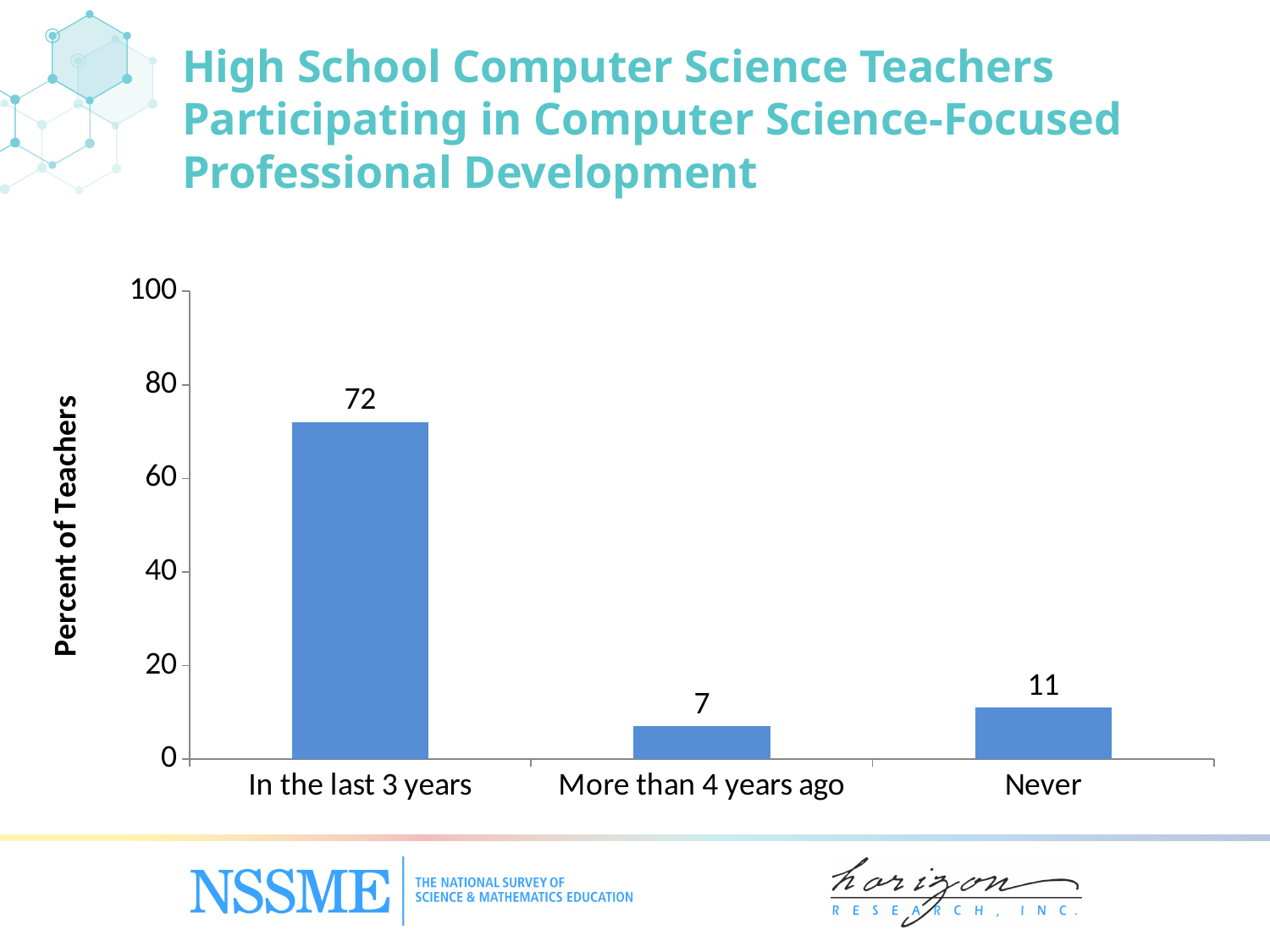
How many categories are shown on the x axis? 3 Which category has the lowest percent of teachers? More than 4 years ago Is the value for 'In the last 3 years' greater or less than 60? greater What is the label of the vertical axis? Percent of Teachers What is the difference between the values for 'Never' and 'More than 4 years ago'? 4 What is the difference between the values for 'In the last 3 years' and 'Never'? 61 What is the value for the 'More than 4 years ago' category? 7 Which category has the highest percent of teachers? In the last 3 years What percent of teachers have never participated in computer science-focused professional development? 11 What kind of chart is shown on the slide? Bar chart Which is larger, the value for 'Never' or the value for 'More than 4 years ago'? Never What percent of teachers participated in computer science-focused professional development in the last 3 years? 72